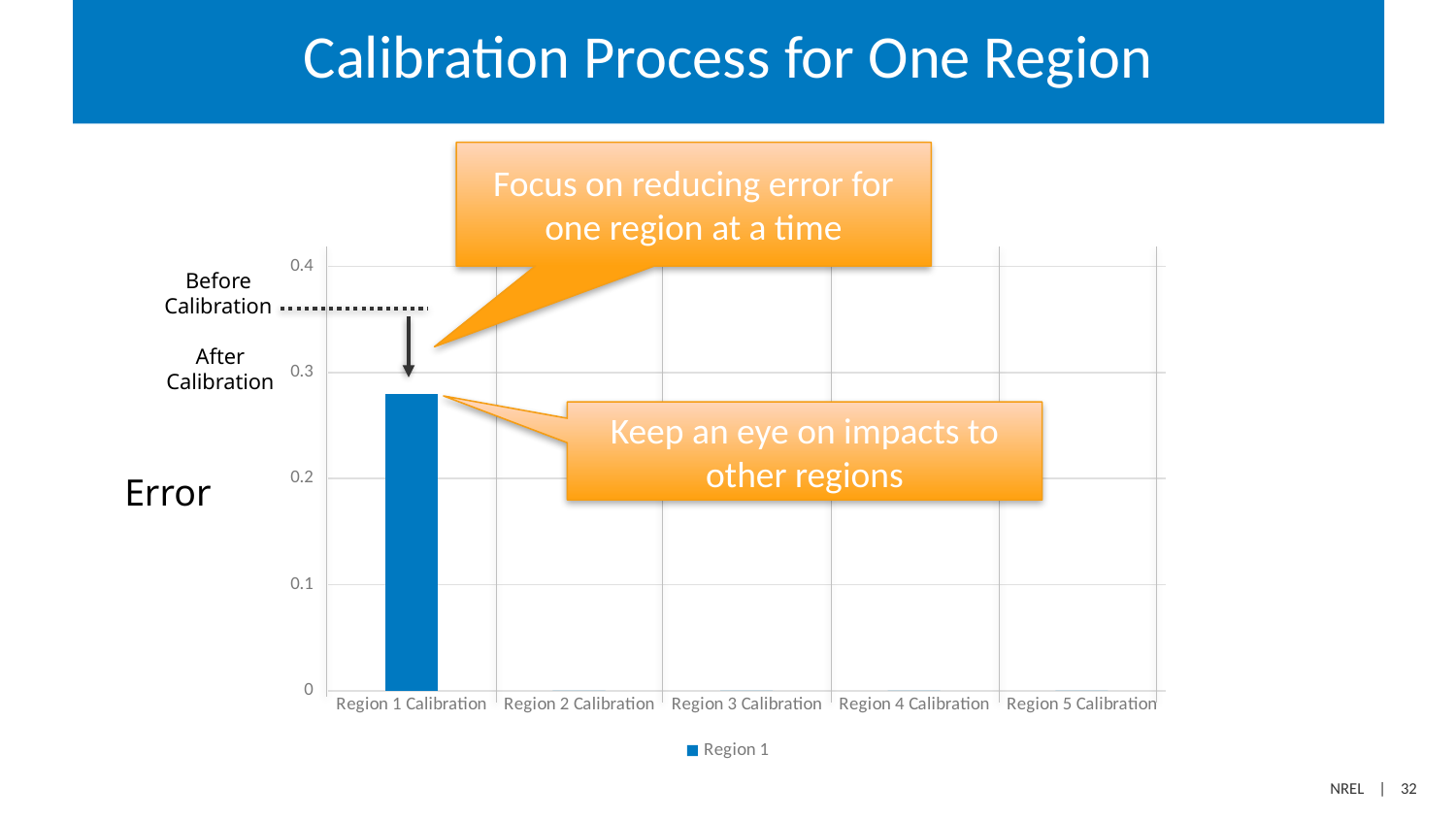
Is the value for Region 1 Calibration greater or less than 0.2? greater Is the value for Region 1 Calibration greater or less than 0.3? less How many series does the chart's legend list? 1 What kind of chart is shown on the slide? bar chart What is the name of the series listed in the chart's legend? Region 1 Which category on the x axis has a plotted bar? Region 1 Calibration What is the label of the last category on the x axis? Region 5 Calibration What is the highest tick value shown on the vertical axis? 0.4 How many categories are shown on the x axis of the chart? 5 What label is shown on the vertical axis of the chart? Error